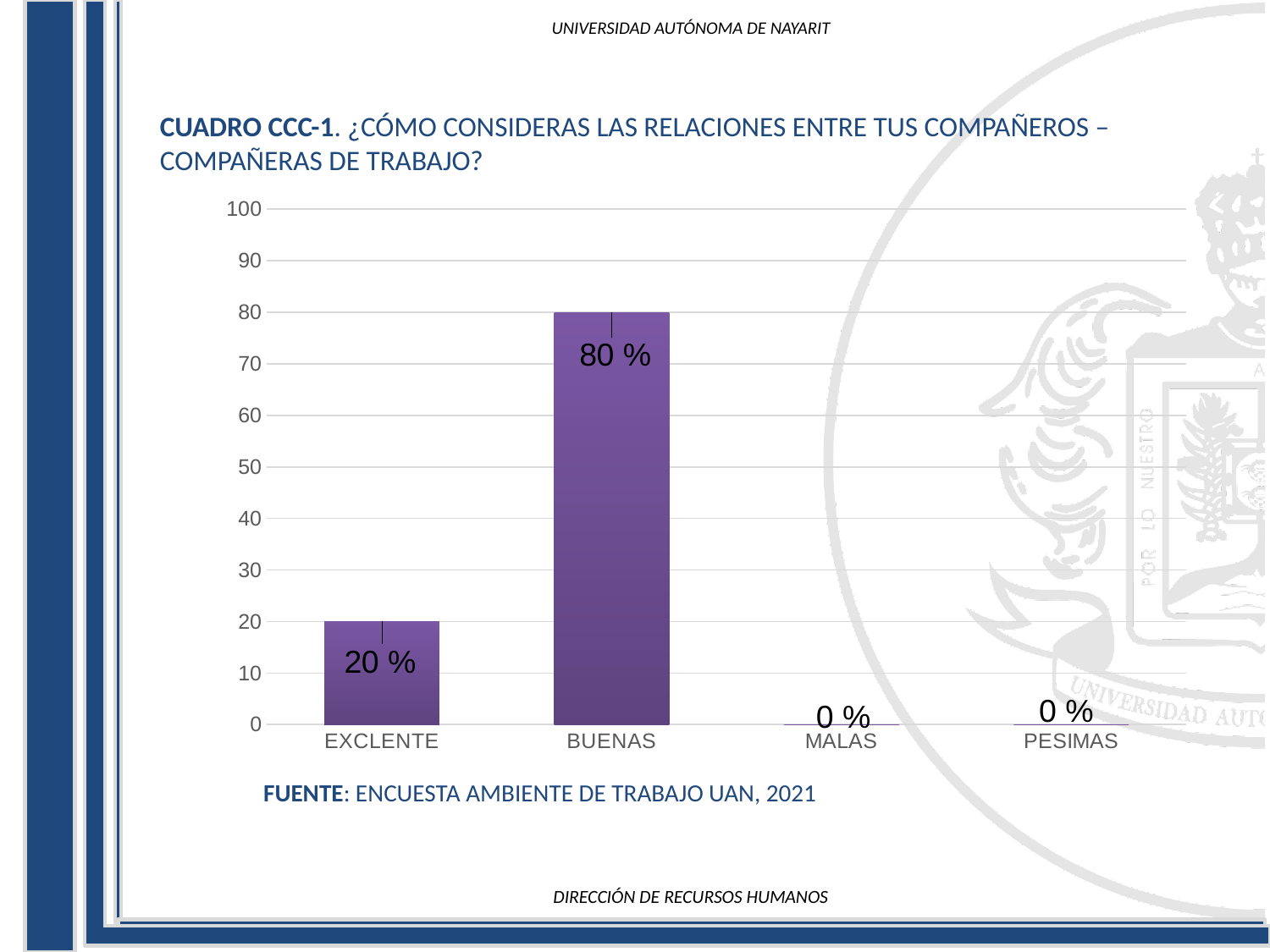
What is the value for EXCLENTE? 20 % Is the value for EXCLENTE greater or less than 30? less What is the value for BUENAS? 80 % What is the source cited below the chart? ENCUESTA AMBIENTE DE TRABAJO UAN, 2021 What is the difference between the values for BUENAS and EXCLENTE? 60 % Is the value for BUENAS greater or less than 50? greater How many categories are shown on the x axis? 4 What is the value for MALAS? 0 % What kind of chart is shown on the slide? Bar chart What is the value for PESIMAS? 0 % Which category has the highest value? BUENAS Which is larger, the value for EXCLENTE or the value for BUENAS? BUENAS